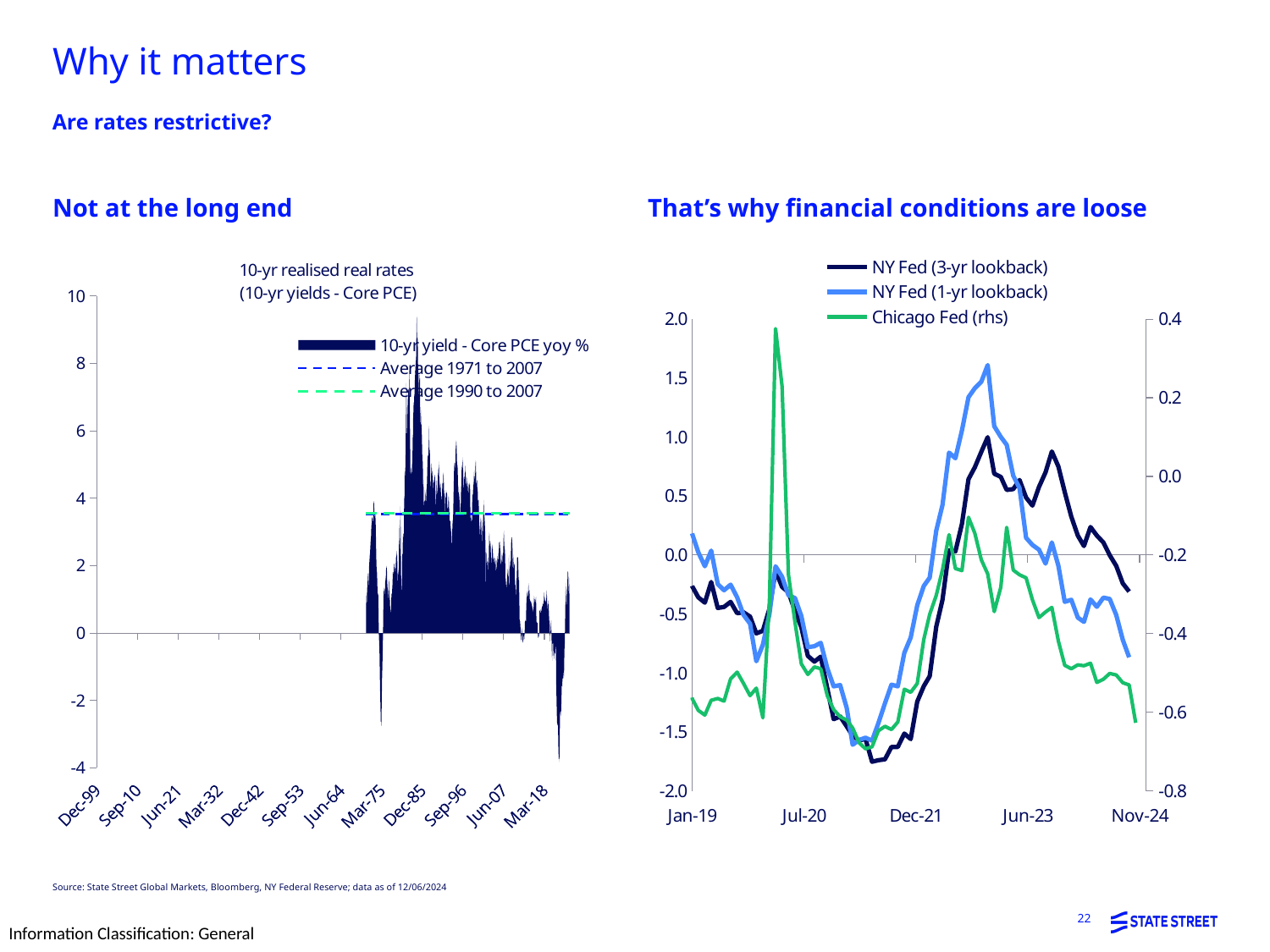
How many date labels are shown on the x axis of the left-hand chart? 12 What kind of chart is the right-hand chart ("That's why financial conditions are loose")? line chart How many entries does the legend of the left-hand chart (10-yr realised real rates) list? 3 In the right-hand chart, is the lowest value of NY Fed (3-yr lookback) greater or less than -1.5? less What is the title of the left-hand chart? 10-yr realised real rates (10-yr yields - Core PCE) In the right-hand chart, is the peak value of Chicago Fed (rhs) near Jul-20 greater or less than 0.2 on the right-hand axis? greater In the right-hand chart, which series is higher at Jan-19: NY Fed (1-yr lookback) or NY Fed (3-yr lookback)? NY Fed (1-yr lookback) In the left-hand chart, is the Average 1971 to 2007 dashed line greater or less than 2? greater In the right-hand chart, does NY Fed (1-yr lookback) rise or fall between Jun-23 and Nov-24? fall In the right-hand chart, which series is plotted on the right-hand axis? Chicago Fed (rhs) How many series does the legend of the right-hand chart list? 3